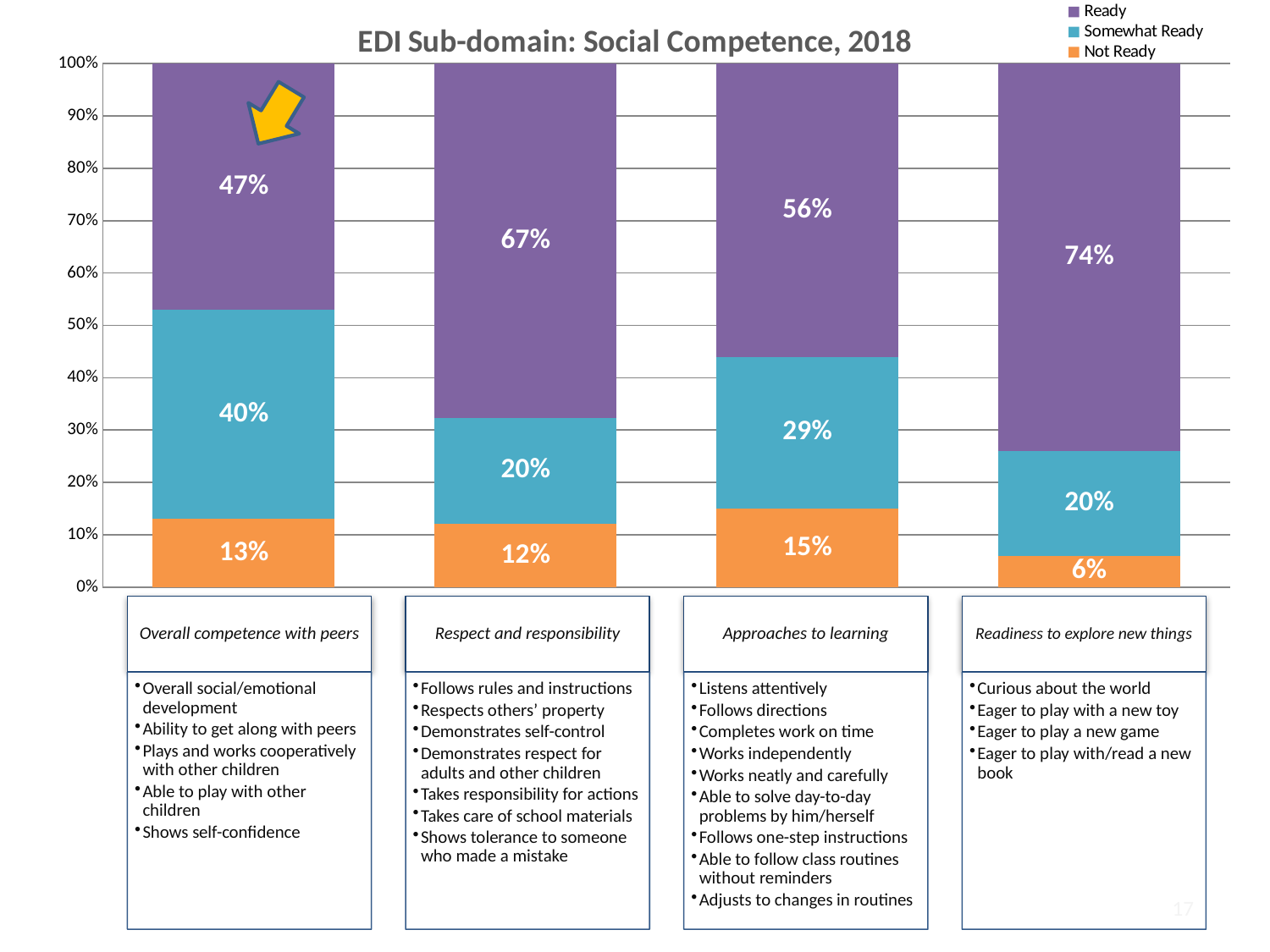
Which is larger: the 'Somewhat Ready' value for Overall competence with peers or for Approaches to learning? Overall competence with peers What is the 'Somewhat Ready' value for Approaches to learning? 29% What is the combined 'Ready' and 'Somewhat Ready' percentage for Approaches to learning? 85% What type of chart is shown on the slide? Stacked bar chart How many sub-domain categories are shown in the chart? 4 What percentage of children are 'Ready' in the Overall competence with peers sub-domain? 47% What is the difference between the 'Ready' percentages for Respect and responsibility and Overall competence with peers? 20% What is the 'Not Ready' value for Readiness to explore new things? 6% Which sub-domain has the lowest 'Not Ready' percentage? Readiness to explore new things Which sub-domain has the highest 'Ready' percentage? Readiness to explore new things What is the title of the chart? EDI Sub-domain: Social Competence, 2018 How many series does the legend list? 3